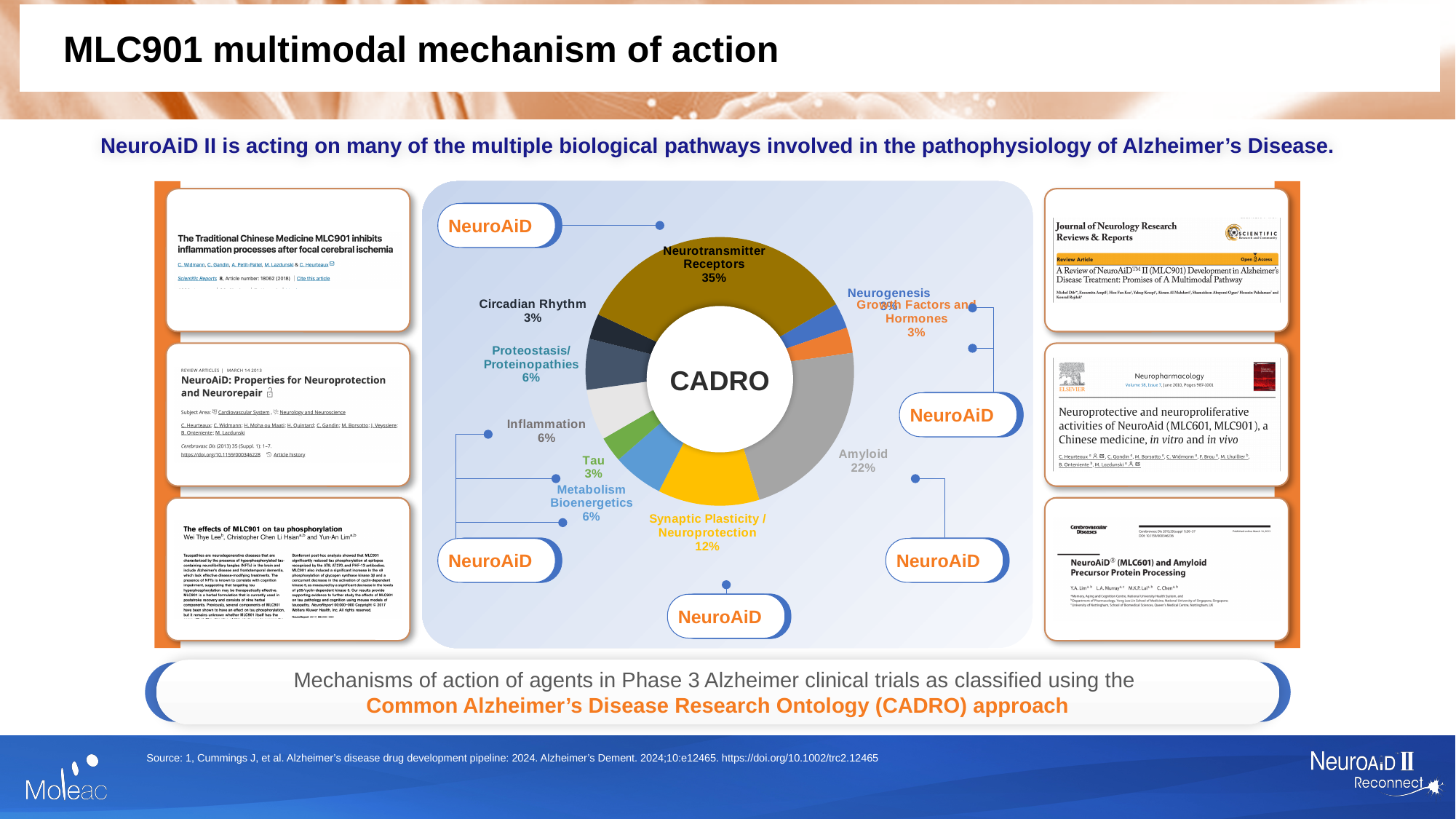
How many percentage points larger is Neurotransmitter Receptors than Amyloid? 13 percentage points What share of the chart is Proteostasis/Proteinopathies? 6% How many percentage points larger is Amyloid than Synaptic Plasticity / Neuroprotection? 10 percentage points What share of the chart is Synaptic Plasticity / Neuroprotection? 12% How many categories are labelled on the chart? 10 What kind of chart is shown in the centre of the slide? pie (donut) chart Which category has the largest share of the chart? Neurotransmitter Receptors What share of the chart is Neurotransmitter Receptors? 35% What share of the chart is Amyloid? 22% What share of the chart is Circadian Rhythm? 3% Which has the larger share, Inflammation or Tau? Inflammation What label appears in the centre of the donut chart? CADRO